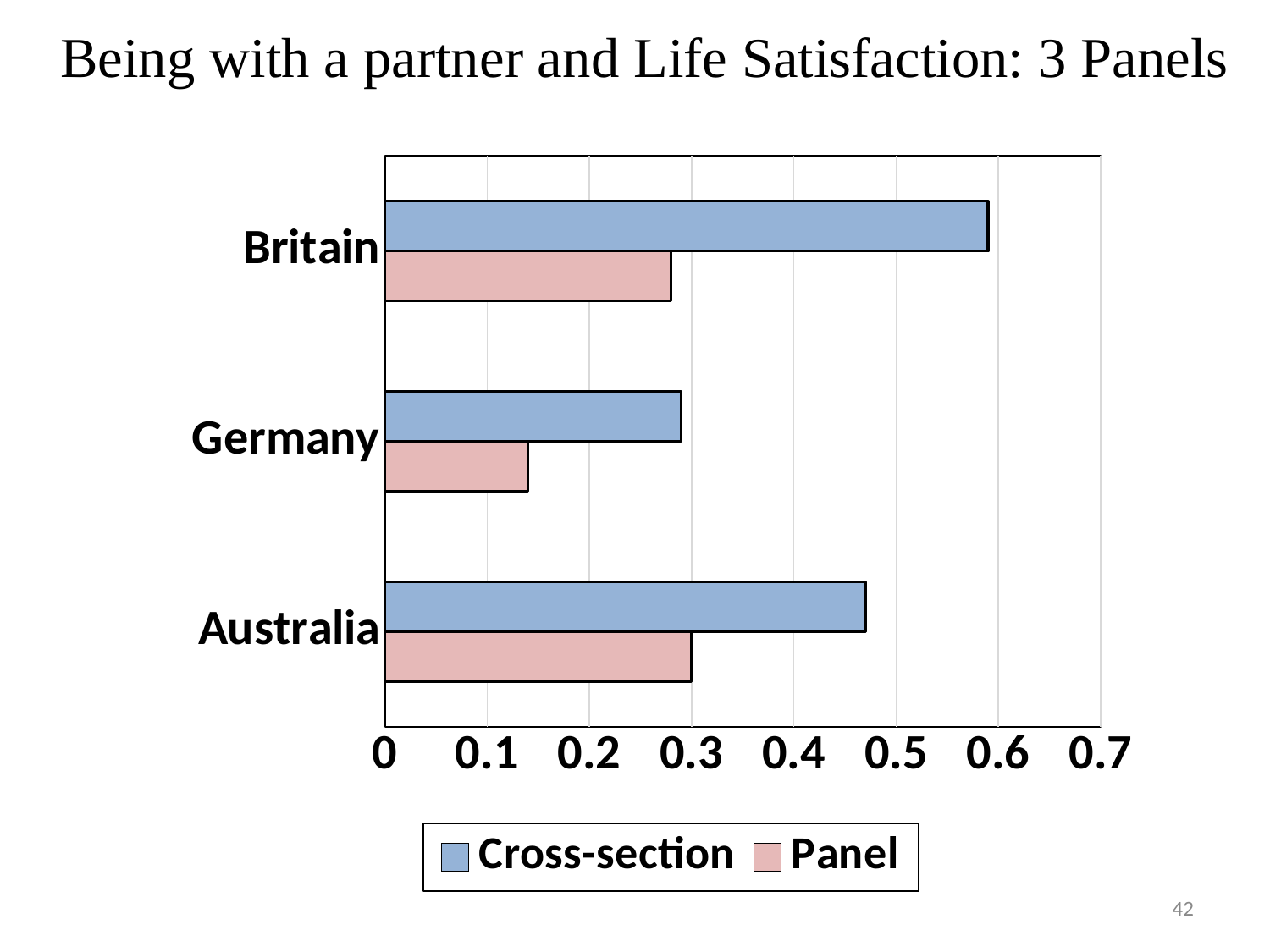
Which country has the lowest Cross-section value? Germany How many series does the legend list? 2 What is the title of the slide? Being with a partner and Life Satisfaction: 3 Panels How many countries are shown on the chart? 3 Which country has the highest Cross-section value? Britain Which is larger for Germany, the Cross-section value or the Panel value? Cross-section Is the Cross-section value for Britain greater or less than 0.5? greater Is the Cross-section value for Australia greater or less than 0.4? greater Which country has the lowest Panel value? Germany What kind of chart is shown on the slide? Bar chart Which is larger, the Cross-section value for Britain or the Cross-section value for Australia? Britain Is the Panel value for Germany greater or less than 0.2? less